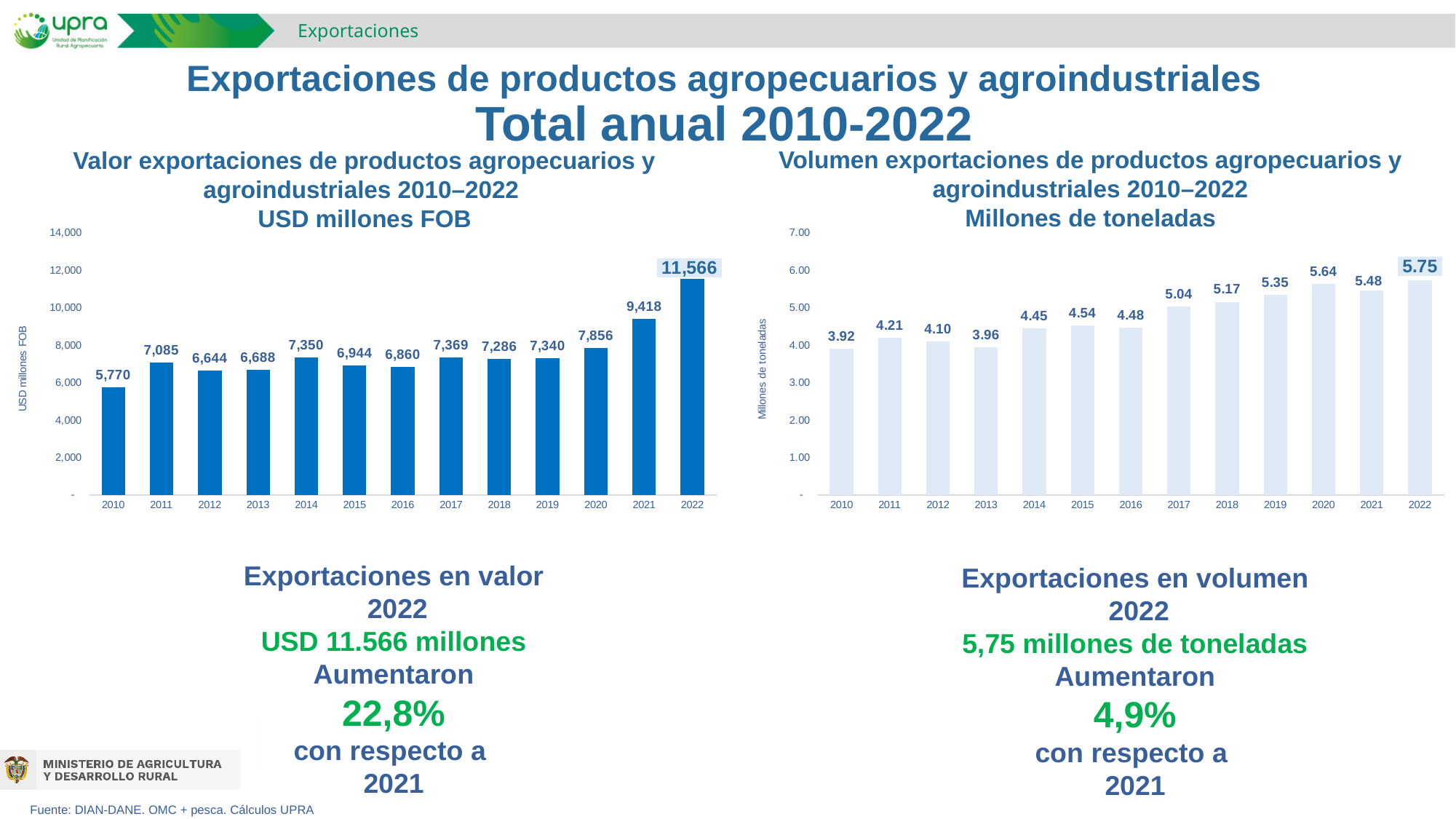
In the left chart (Valor exportaciones, USD millones FOB), what is the value for 2021? 9,418 What type of chart is the right chart (Volumen exportaciones, Millones de toneladas)? Bar chart In the right chart (Volumen exportaciones, Millones de toneladas), which is larger, the value for 2020 or the value for 2021? 2020 In the right chart (Volumen exportaciones, Millones de toneladas), which year has the lowest value? 2010 In the left chart (Valor exportaciones, USD millones FOB), what is the difference between the 2022 value and the 2021 value? 2,148 In the left chart (Valor exportaciones, USD millones FOB), which year has the lowest value? 2010 In the right chart (Volumen exportaciones, Millones de toneladas), what is the difference between the 2022 value and the 2010 value? 1.83 In the left chart (Valor exportaciones, USD millones FOB), how many years are plotted? 13 In the right chart (Volumen exportaciones, Millones de toneladas), what is the value for 2017? 5.04 In the left chart (Valor exportaciones, USD millones FOB), what is the value for 2010? 5,770 In the left chart (Valor exportaciones, USD millones FOB), which year has the highest value? 2022 In the left chart (Valor exportaciones, USD millones FOB), is the value for 2020 greater or less than 8,000? less